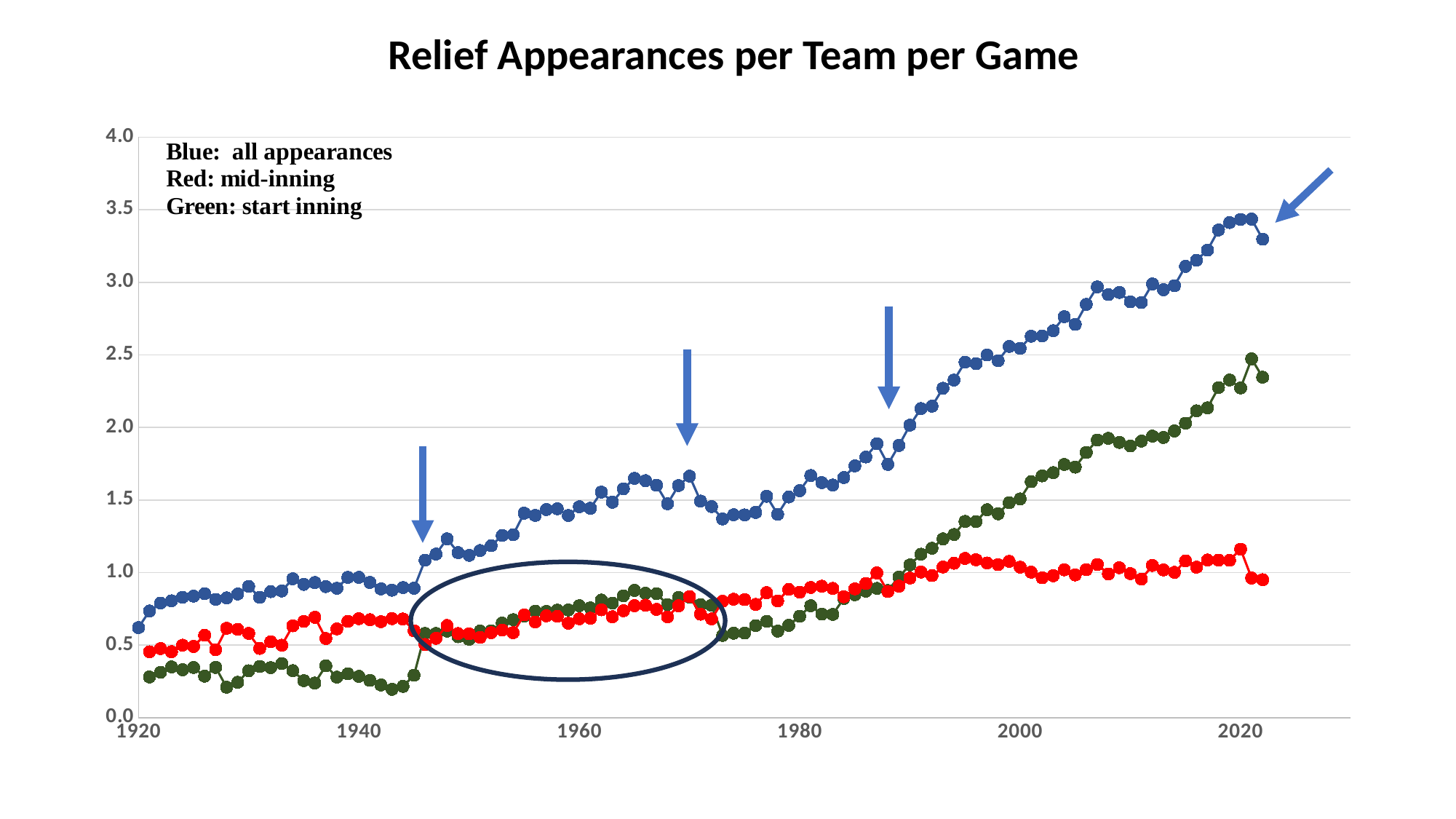
Is the value of the blue (all appearances) series in 1980 greater or less than 2.0? less Which series has the highest value in 2020? Blue (all appearances) Is the value of the blue (all appearances) series in 2020 greater or less than 3.0? greater How many series does the legend list? 3 What is the title of the chart? Relief Appearances per Team per Game In 2000, which is larger: the green (start inning) value or the red (mid-inning) value? green (start inning) What kind of chart is shown on the slide? line chart Which series has the lowest value in 1930? Green (start inning) Is the value of the green (start inning) series in 2000 greater or less than 1.0? greater Does the blue (all appearances) series generally rise or fall from 1920 to 2020? rise Which colour represents mid-inning relief appearances? Red